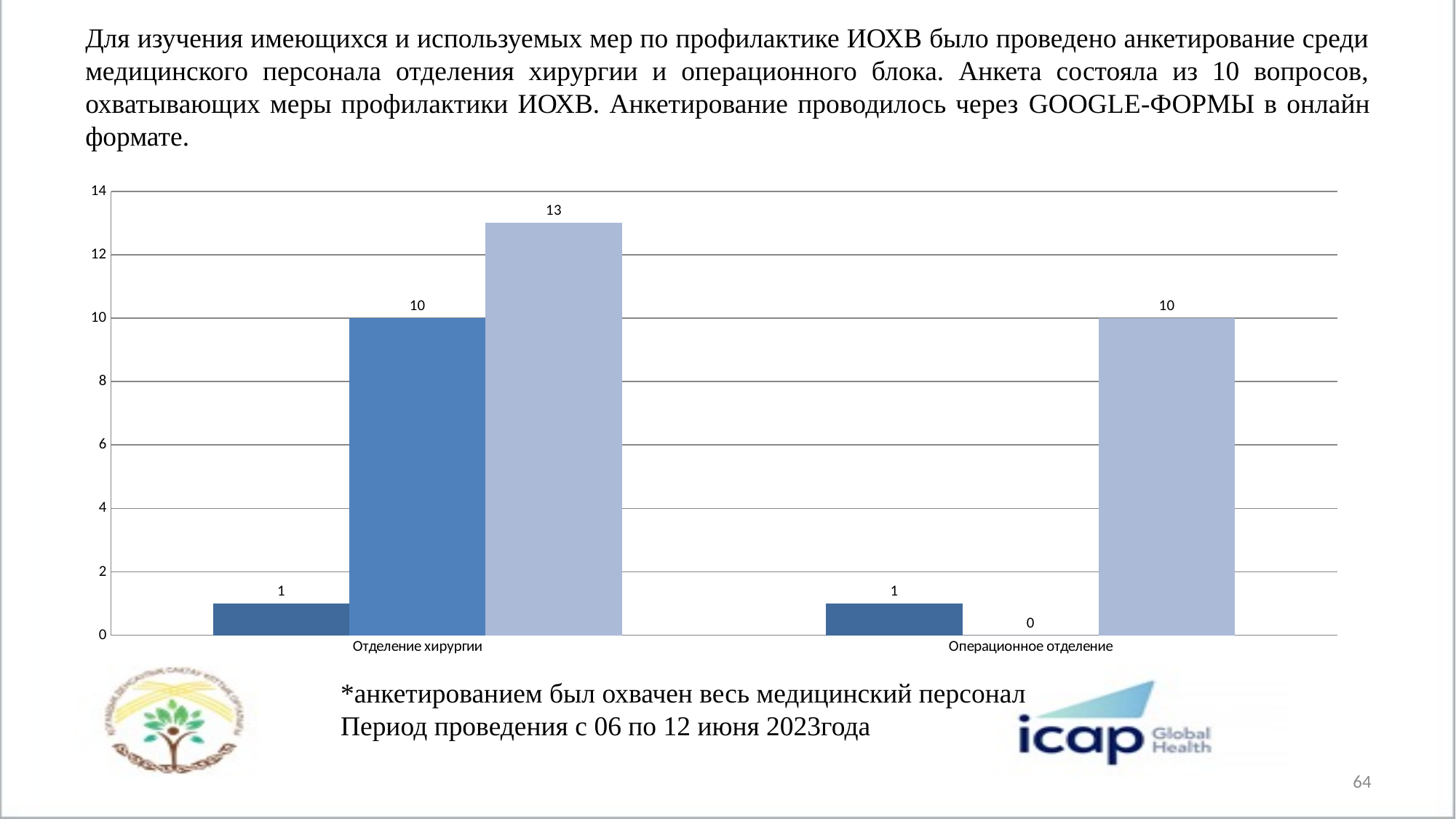
What is the value of the medium blue bar for Отделение хирургии? 10 How many categories are shown on the x axis of the chart? 2 What type of chart is shown on the slide? bar chart What is the value of the medium blue bar for Операционное отделение? 0 What is the value of the dark blue bar for Операционное отделение? 1 What is the difference between the light blue bar for Отделение хирургии and the light blue bar for Операционное отделение? 3 What is the value of the light blue bar for Операционное отделение? 10 What is the highest value shown on the vertical axis of the chart? 14 Which category has the highest single bar in the chart? Отделение хирургии Which is larger: the medium blue bar for Отделение хирургии or the medium blue bar for Операционное отделение? Отделение хирургии What is the sum of the three bars for Отделение хирургии? 24 What is the value of the light blue bar for Отделение хирургии? 13